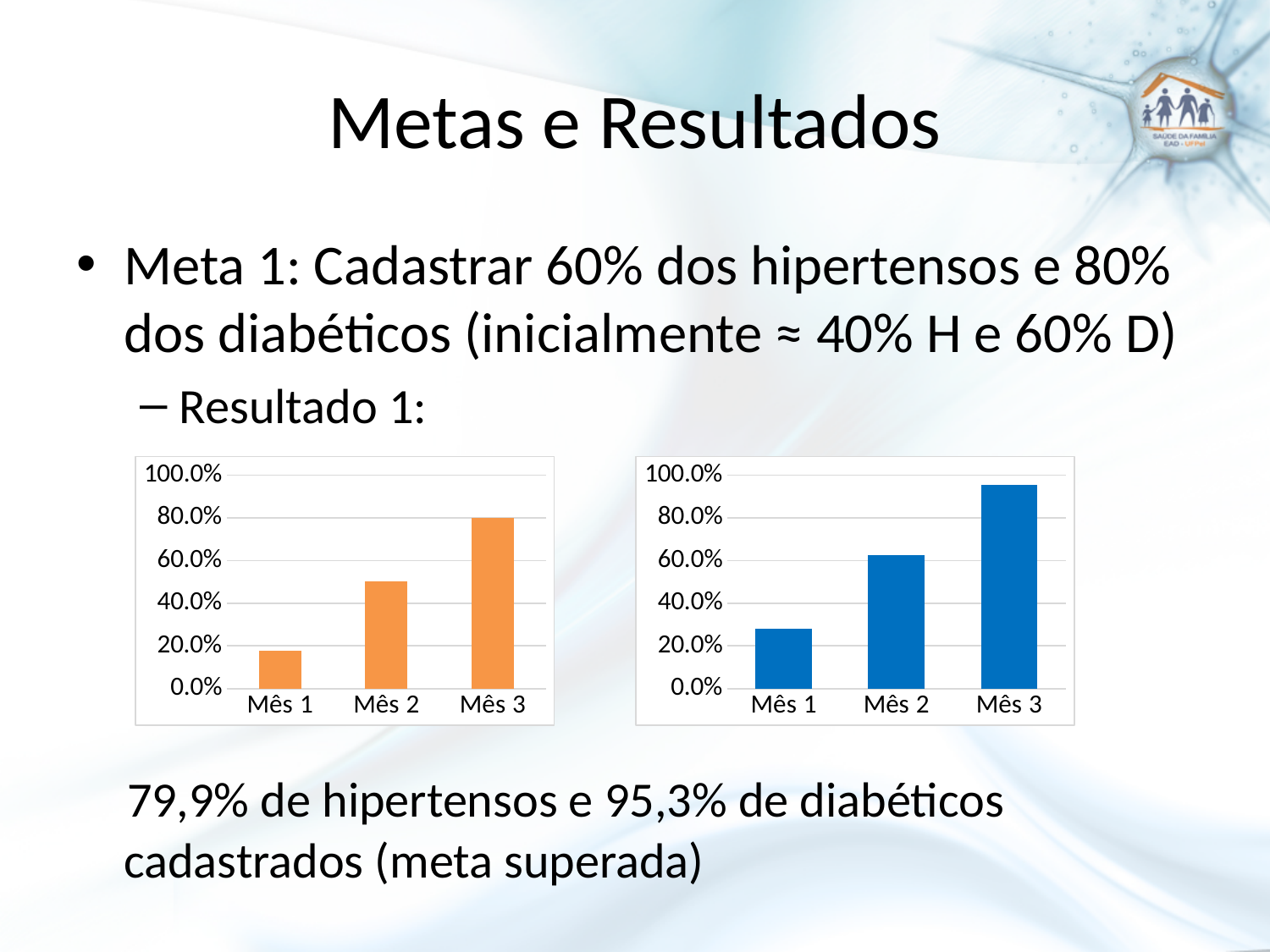
In the left chart, which month has the lowest value? Mês 1 What colour are the bars in the right chart? blue In the left chart, do the values rise or fall from Mês 1 to Mês 3? rise In the left chart, which month has the highest value? Mês 3 How many categories does the right chart show? 3 In the right chart, which is larger, the value for Mês 2 or the value for Mês 1? Mês 2 In the right chart, is the value for Mês 1 greater or less than 20.0%? greater In the right chart, which month has the lowest value? Mês 1 What kind of chart is the left chart on the slide? bar chart In the right chart, is the value for Mês 3 greater or less than 80.0%? greater In the left chart, is the value for Mês 1 greater or less than 20.0%? less In the right chart, which month has the highest value? Mês 3